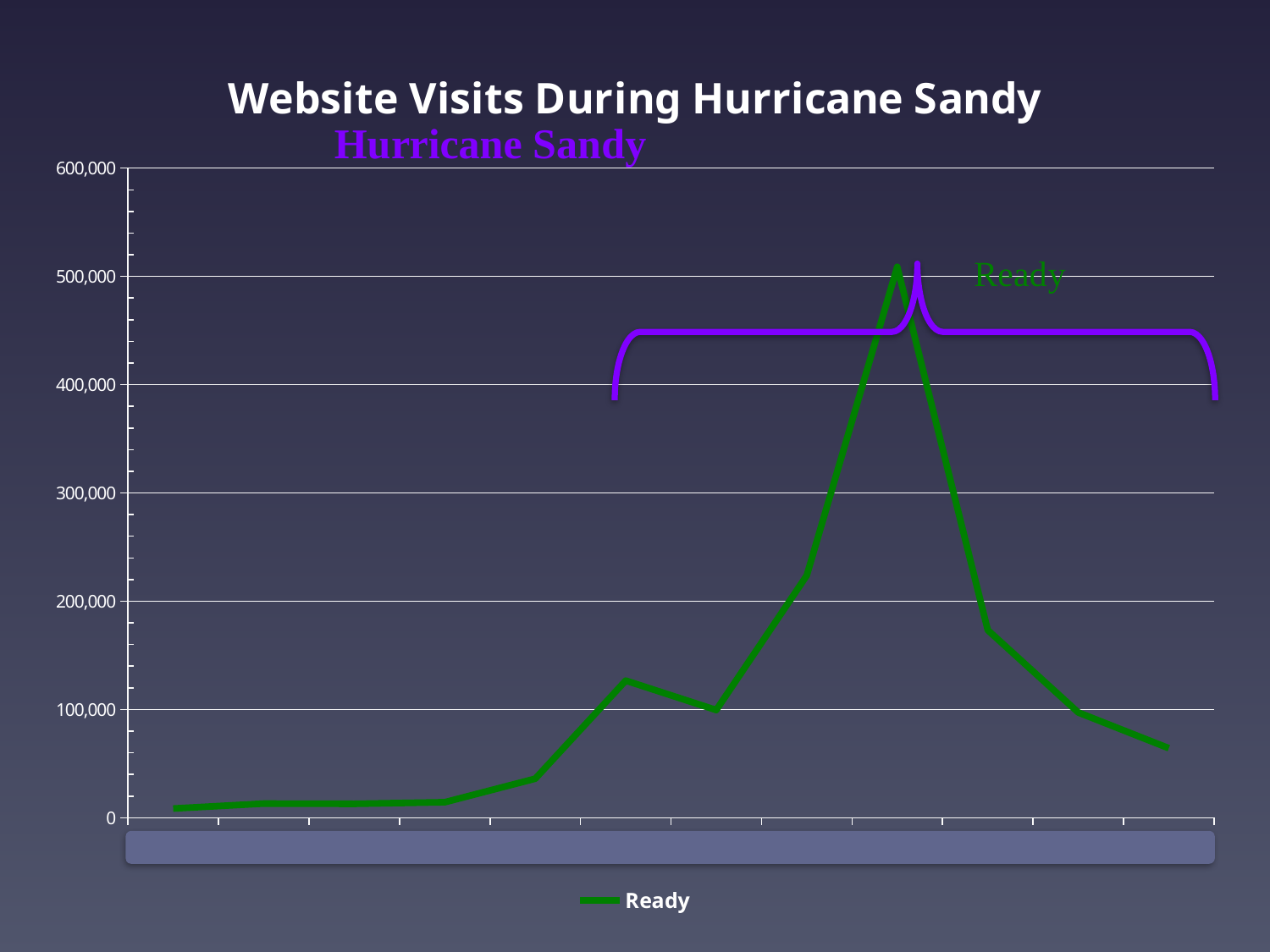
What is the title of the chart? Website Visits During Hurricane Sandy Do the values of the Ready line rise or fall from the peak to the end of the x axis? fall Do the values of the Ready line rise or fall from the start of the x axis up to the peak? rise What kind of chart is shown on the slide? line chart What is the name of the series shown in the legend? Ready How many series does the legend list? 1 Is the last value of the Ready line greater or less than 100,000? less Is the highest value of the Ready line greater or less than 600,000? less What is the highest value shown on the y axis? 600,000 Is the first value of the Ready line greater or less than 100,000? less